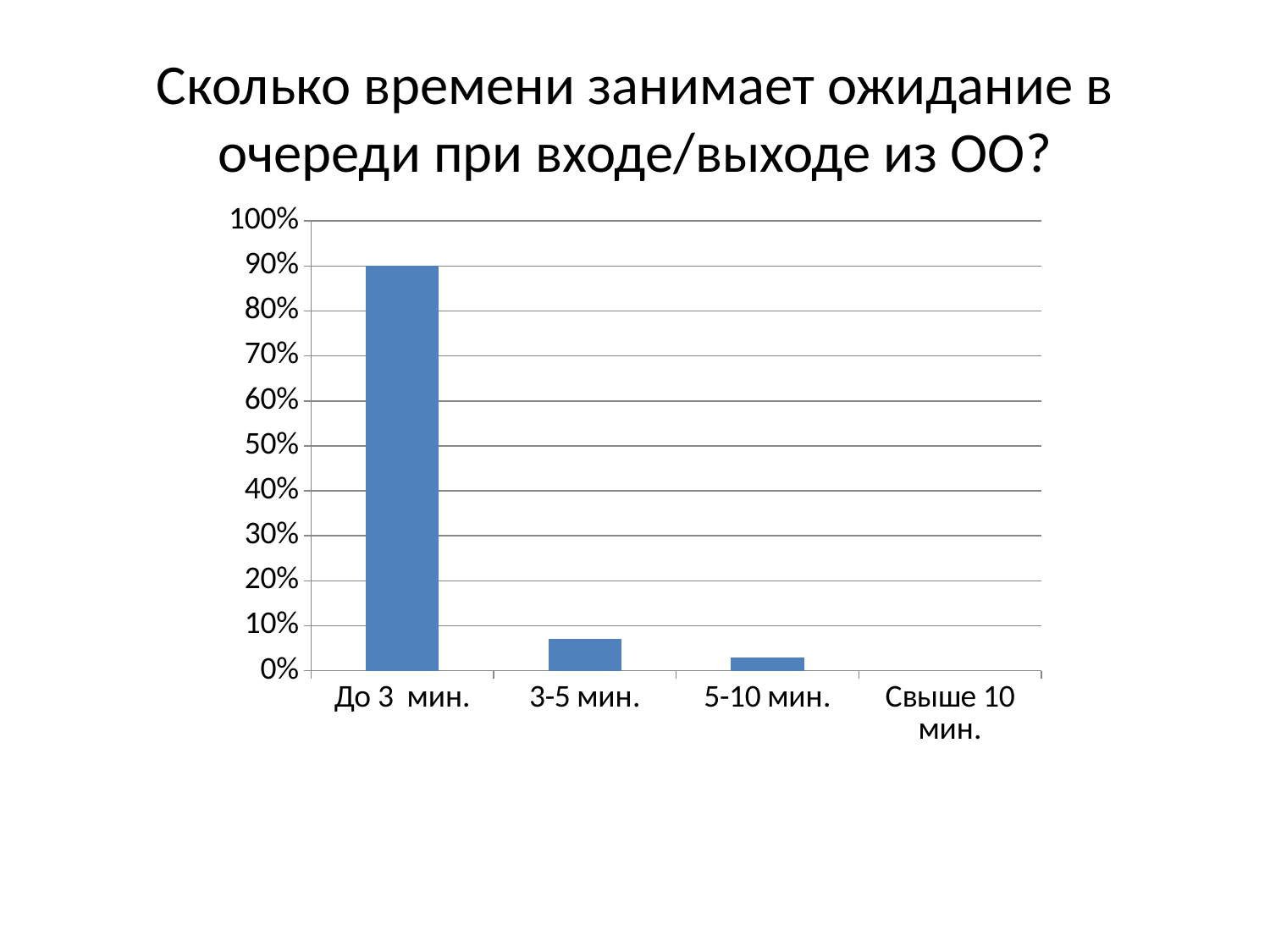
Which is larger, the value for "3-5 мин." or the value for "5-10 мин."? 3-5 мин. What is the title of the chart on the slide? Сколько времени занимает ожидание в очереди при входе/выходе из ОО? What kind of chart is shown on the slide? bar chart Is the value for "До 3 мин." greater or less than 80%? greater Which category has the highest value in the chart? До 3 мин. How many categories are shown on the x axis of the chart? 4 Is the value for "3-5 мин." greater or less than 10%? less Do the values rise or fall from left to right along the x axis? fall Is the value for "5-10 мин." greater or less than 10%? less What is the value for the category "До 3 мин."? 90%